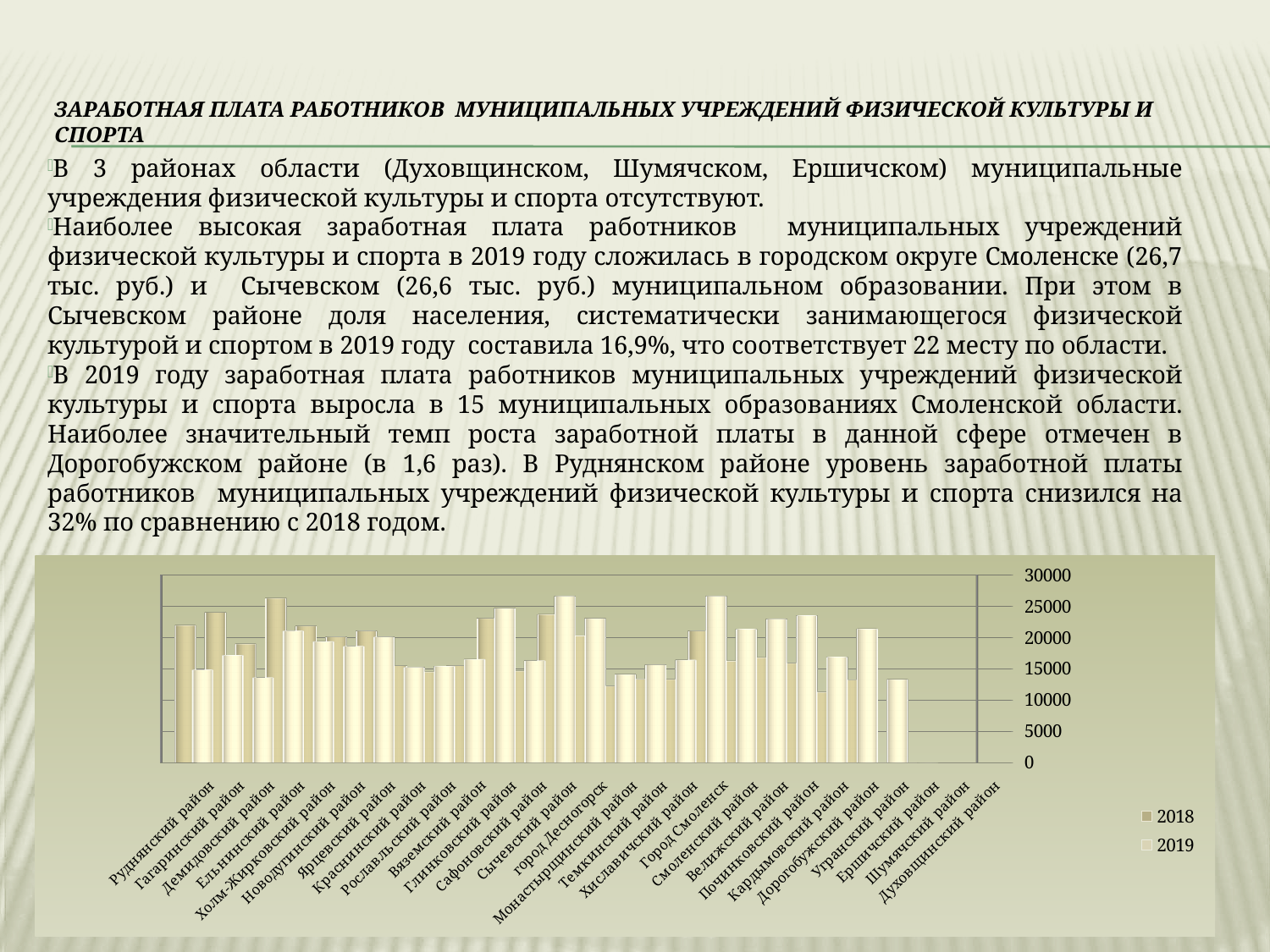
For Руднянский район, which is larger: the 2018 value or the 2019 value? 2018 Is the 2018 value for Дорогобужский район greater or less than 15000? less Is the 2018 value for Руднянский район greater or less than 20000? greater What kind of chart is shown on the slide? bar chart How many districts (categories) are shown along the x axis of the chart? 27 What are the two series named in the chart legend? 2018 and 2019 For Дорогобужский район, which is larger: the 2018 value or the 2019 value? 2019 Is the 2019 value for Город Смоленск greater or less than 25000? greater How many series does the chart legend list? 2